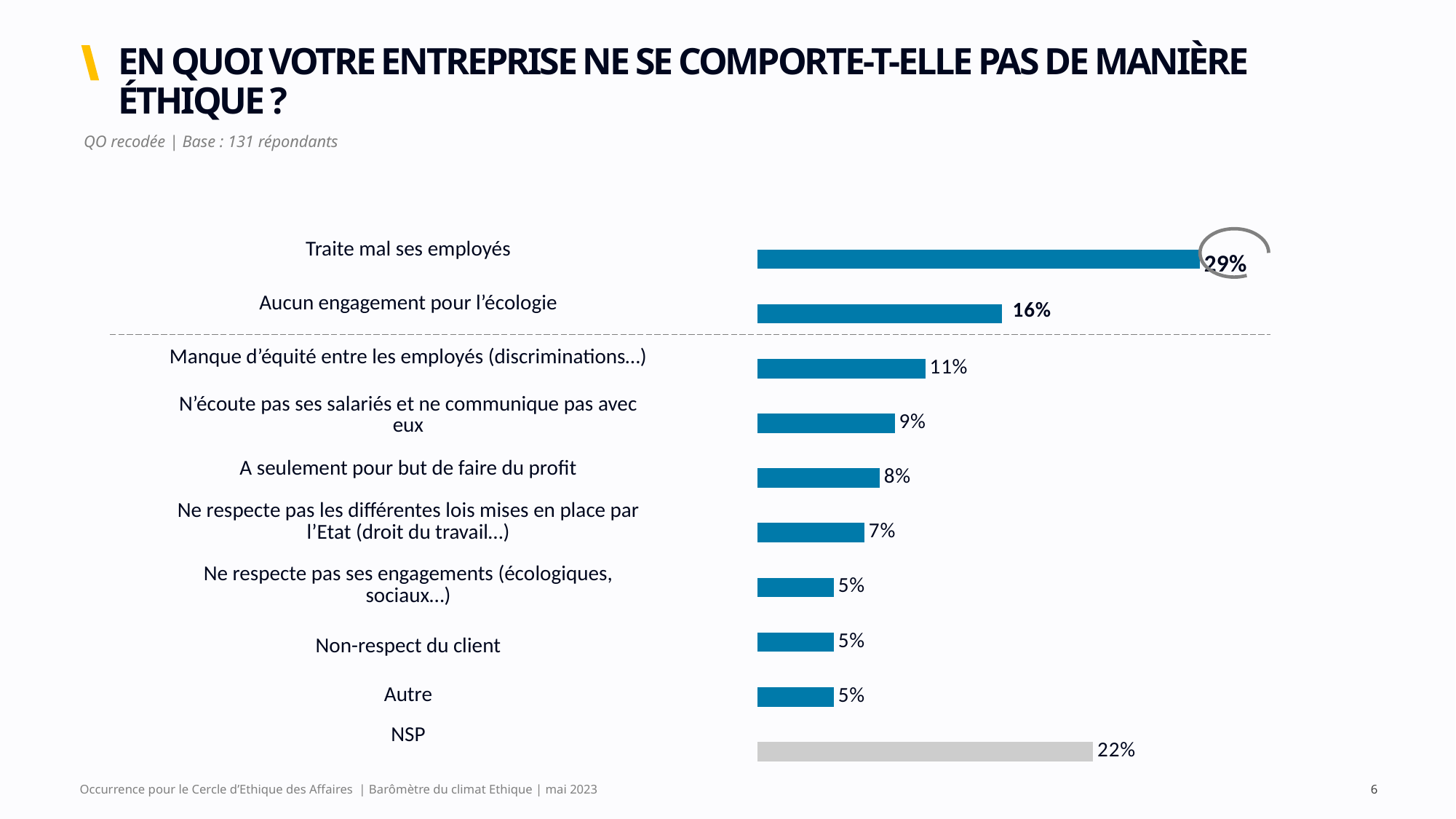
What kind of chart is shown on the slide? Bar chart What is the difference between "Traite mal ses employés" and "Aucun engagement pour l'écologie"? 13 percentage points How many categories have a value of 5%? 3 Which is larger: "Manque d'équité entre les employés (discriminations…)" or "N'écoute pas ses salariés et ne communique pas avec eux"? Manque d'équité entre les employés (discriminations…) What is the difference between "NSP" and "Ne respecte pas les différentes lois mises en place par l'Etat (droit du travail…)"? 15 percentage points What is the value for "A seulement pour but de faire du profit"? 8% How many categories are shown in the chart? 10 What is the value for "Aucun engagement pour l'écologie"? 16% Which bar is shown in grey rather than blue? NSP What is the value for "Traite mal ses employés"? 29% What is the value for "NSP"? 22% Which category has the highest value? Traite mal ses employés